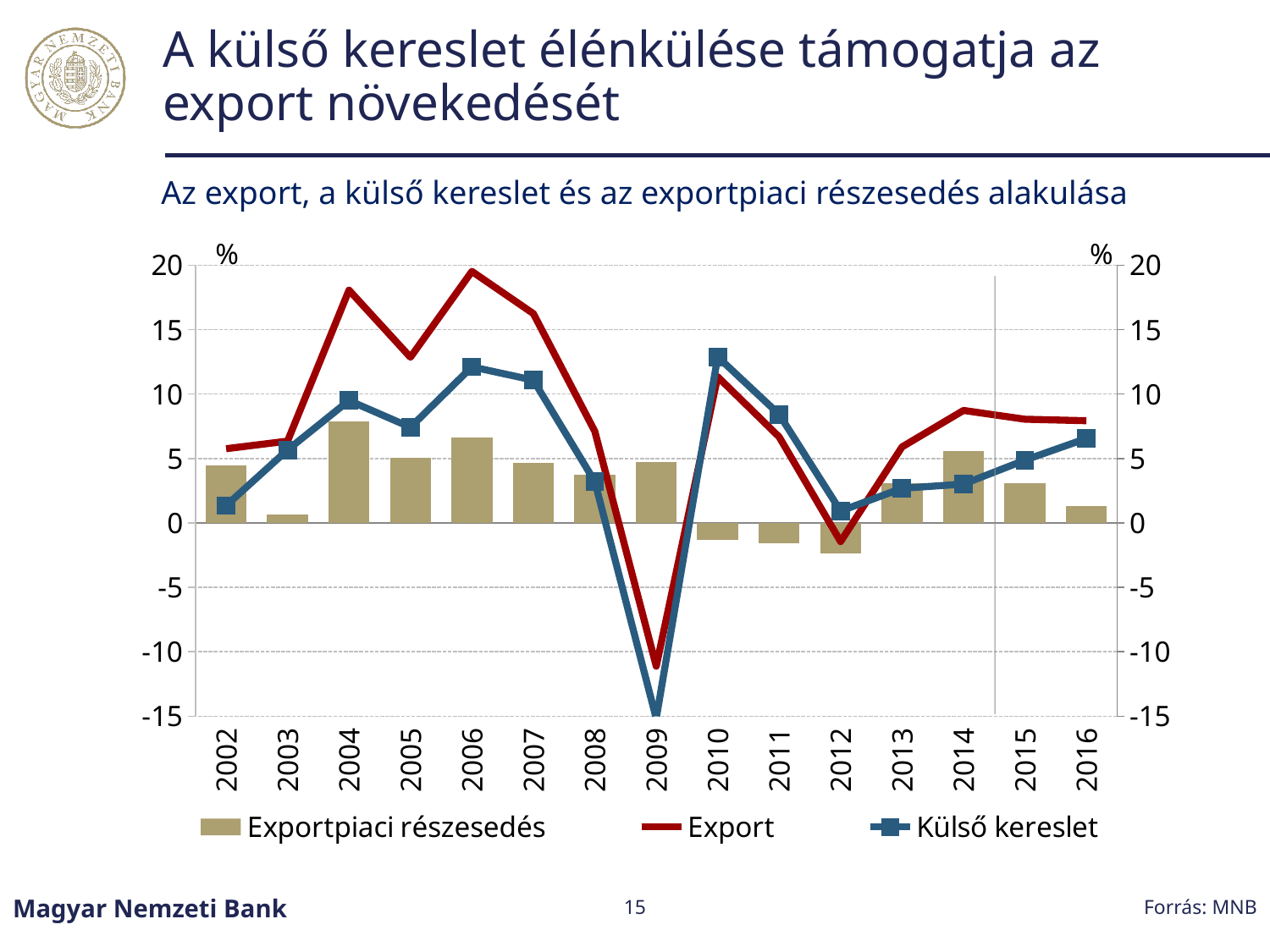
Is the Külső kereslet value for 2010 greater or less than 10? greater In 2006, which is larger: the Export value or the Külső kereslet value? Export What kind of chart is shown on the slide? A combined bar and line chart In which year does the Külső kereslet series reach its lowest value? 2009 What is the title of the chart? Az export, a külső kereslet és az exportpiaci részesedés alakulása In which year does the Export series reach its lowest value? 2009 How many years are shown on the x axis? 15 In which year is the Exportpiaci részesedés bar the lowest? 2012 In which year is the Exportpiaci részesedés bar the tallest? 2004 Is the Export value for 2004 greater or less than 15? greater In which year does the Export series reach its highest value? 2006 How many series does the legend list? 3